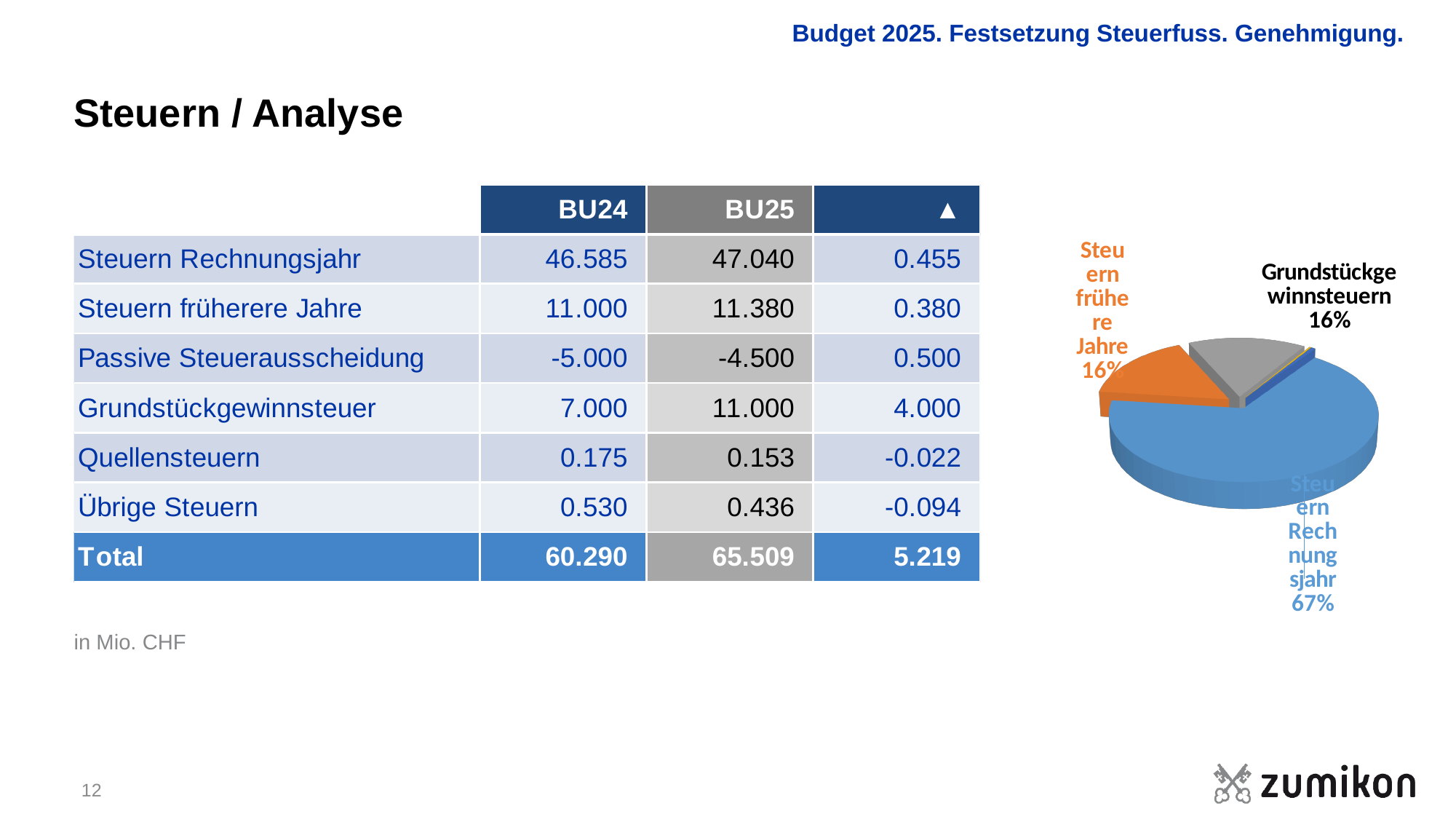
What colour is the Steuern frühere Jahre slice in the pie chart? orange In the pie chart, how many percentage points larger is the Steuern Rechnungsjahr share than the Grundstückgewinnsteuern share? 51 percentage points In the pie chart, what share does Steuern frühere Jahre have? 16% In the pie chart, which is larger: Steuern Rechnungsjahr or Grundstückgewinnsteuern? Steuern Rechnungsjahr What kind of chart is shown on the right of the slide? pie chart In the pie chart, how many percentage points larger is the Steuern Rechnungsjahr share than the Steuern frühere Jahre share? 51 percentage points What colour is the Steuern Rechnungsjahr slice in the pie chart? blue Which slice of the pie chart is the largest? Steuern Rechnungsjahr In the pie chart, what share does Steuern Rechnungsjahr have? 67% In the pie chart, what share does Grundstückgewinnsteuern have? 16%